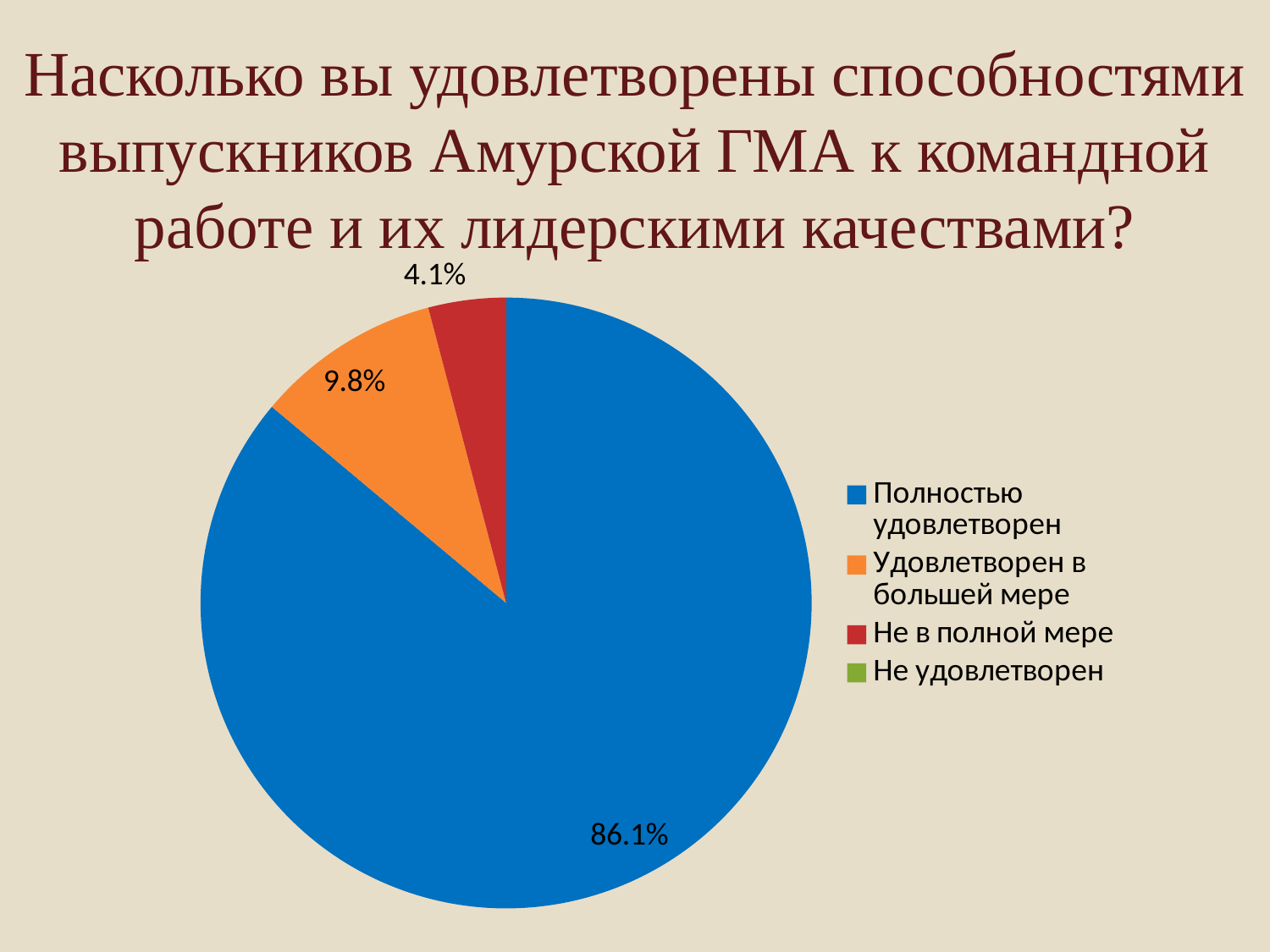
Which colour represents "Полностью удовлетворен" in the chart? blue Which legend entry has no visible slice in the pie? Не удовлетворен Which category has the largest slice of the pie? Полностью удовлетворен What is the difference between the shares for "Полностью удовлетворен" and "Удовлетворен в большей мере"? 76.3% Which is larger: the share for "Удовлетворен в большей мере" or for "Не в полной мере"? Удовлетворен в большей мере What share of respondents answered "Не в полной мере"? 4.1% How many entries does the legend list? 4 What share of respondents answered "Полностью удовлетворен"? 86.1% What kind of chart is shown on the slide? pie chart What is the difference between the shares for "Удовлетворен в большей мере" and "Не в полной мере"? 5.7% What share of respondents answered "Удовлетворен в большей мере"? 9.8% Which of the visible slices is the smallest? Не в полной мере